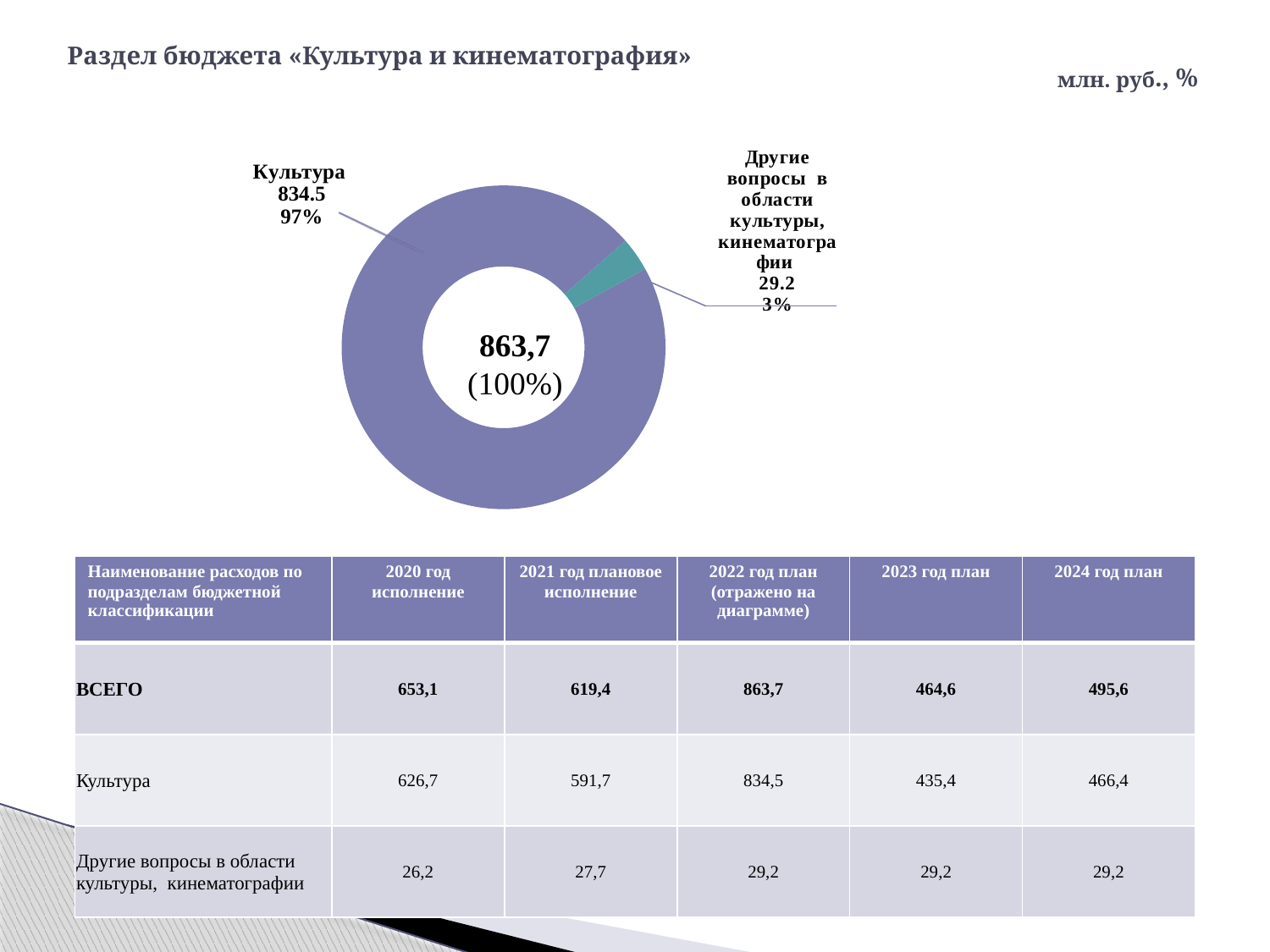
What percentage share does Другие вопросы в области культуры, кинематографии have in the chart? 3% What total value is shown in the centre of the chart? 863,7 What is the value shown for Другие вопросы в области культуры, кинематографии in the chart? 29.2 What percentage share does Культура have in the chart? 97% How many slices does the chart have? 2 What units are stated for the chart in the top right of the slide? млн. руб., % Which category has the largest slice in the chart? Культура What is the value shown for Культура in the chart? 834.5 What kind of chart is shown on the slide? Doughnut (pie) chart Which category has the smallest slice in the chart? Другие вопросы в области культуры, кинематографии What is the difference between the values for Культура and Другие вопросы в области культуры, кинематографии in the chart? 805.3 Which is larger in the chart: Культура or Другие вопросы в области культуры, кинематографии? Культура